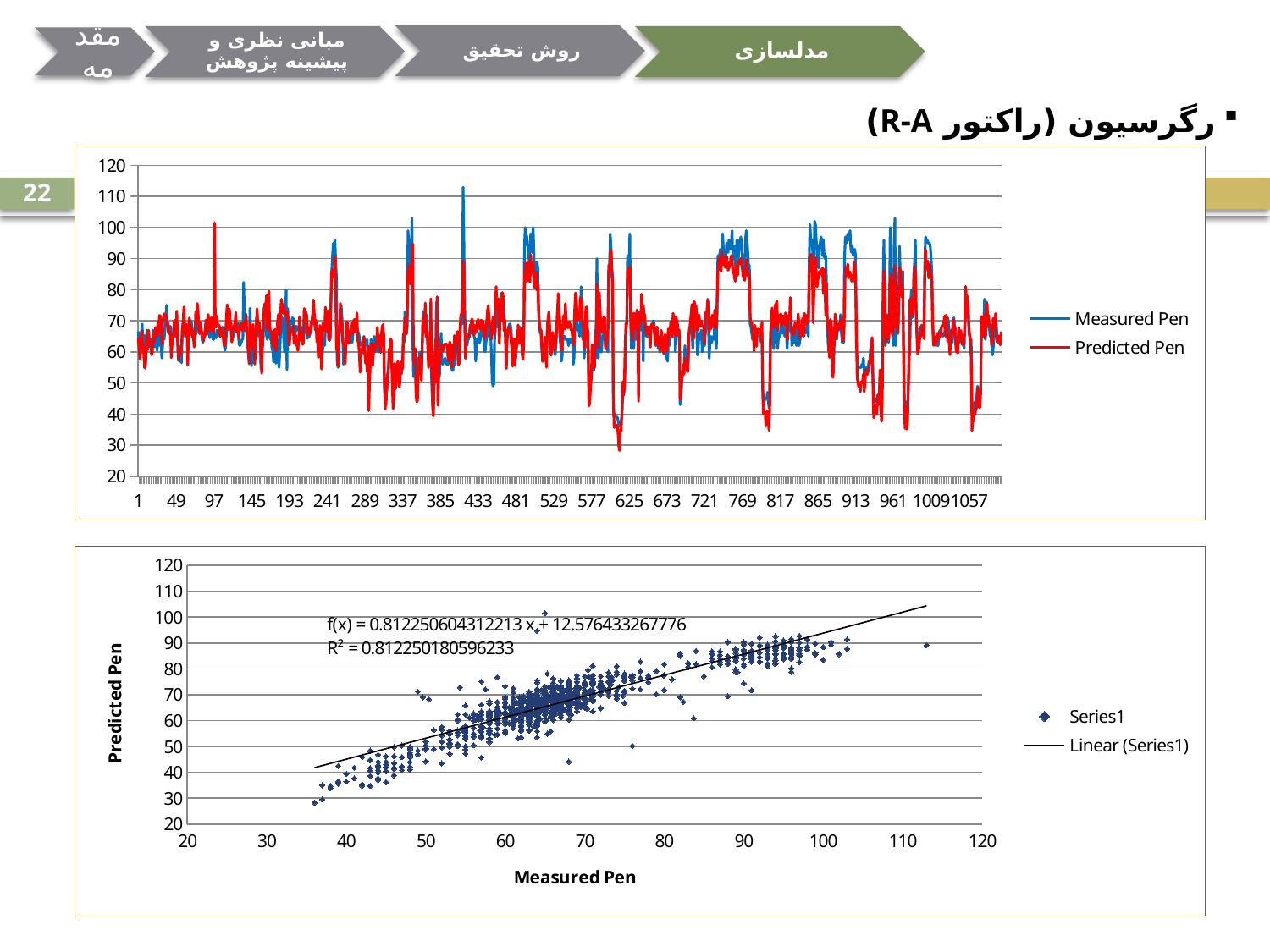
What is the R² value printed on the bottom chart? 0.812250180596233 In the top chart, which colour is used for the Predicted Pen series? red What kind of chart is the bottom chart on the slide? scatter chart How many entries does the legend of the bottom chart list? 2 What are the two series named in the legend of the top chart? Measured Pen and Predicted Pen In the bottom chart, do the Predicted Pen values rise or fall as Measured Pen increases along the x axis? rise In the top chart, is the value of Predicted Pen at x = 1 greater or less than 80? less How many series does the legend of the top chart list? 2 What kind of chart is the top chart on the slide? line chart What is the equation of the trend line printed on the bottom chart? f(x) = 0.812250604312213 x + 12.576433267776 What is the x-axis title of the bottom chart? Measured Pen